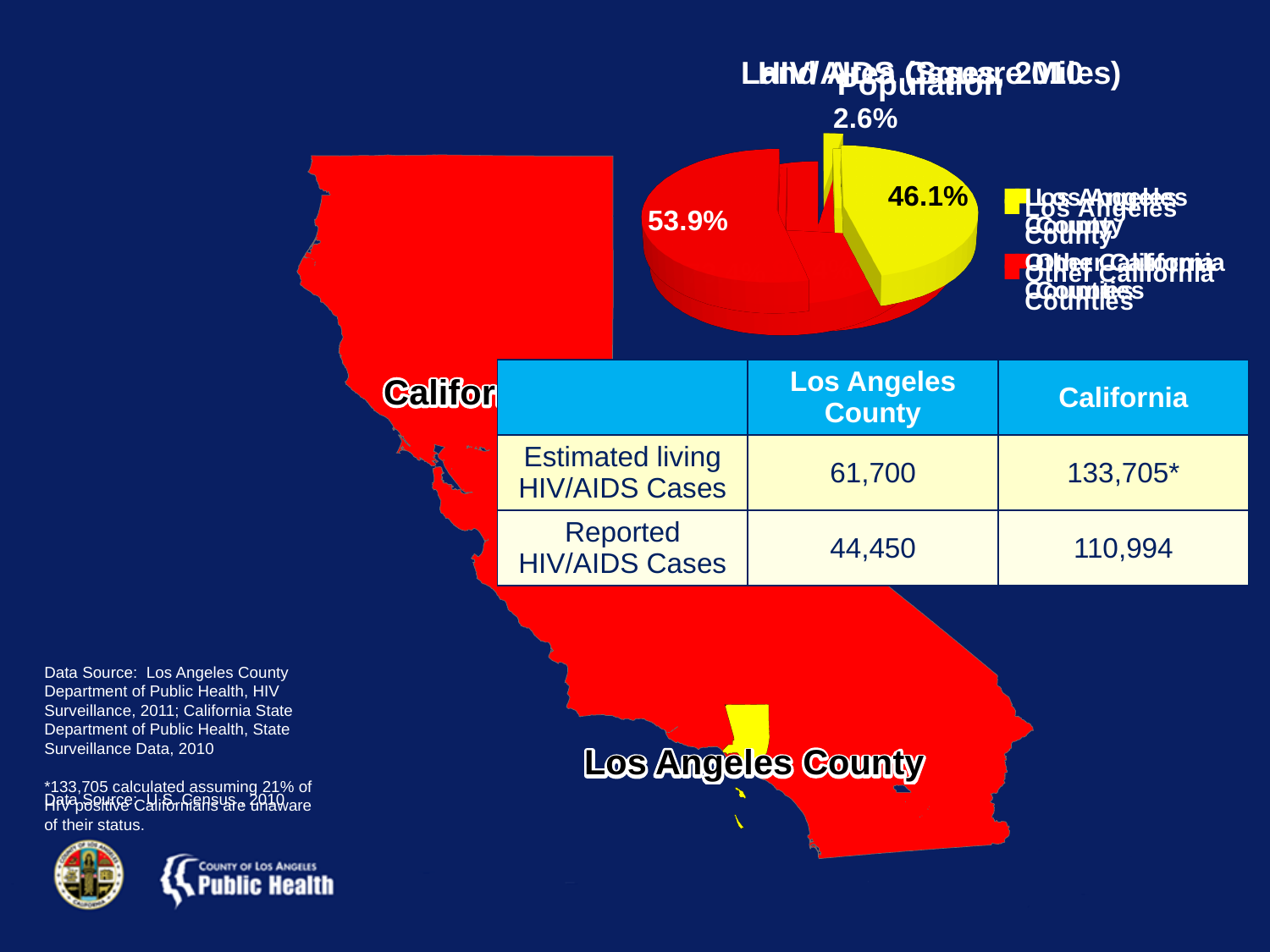
In the pie chart at the top right, which slice is larger, the red one or the yellow one? the red one In the pie chart at the top right, which legend entry is shown in yellow? Los Angeles County In the pie chart at the top right, which legend entry is shown in red? Other California Counties What kind of chart is shown at the top right of the slide? pie chart In the pie chart at the top right, what percentage is printed on the red slice? 53.9% In the pie chart at the top right, what is the difference between the red slice (53.9%) and the yellow slice (46.1%)? 7.8% In the pie chart at the top right, what percentage is printed on the yellow slice? 46.1% How many entries does the legend of the pie chart at the top right list? 2